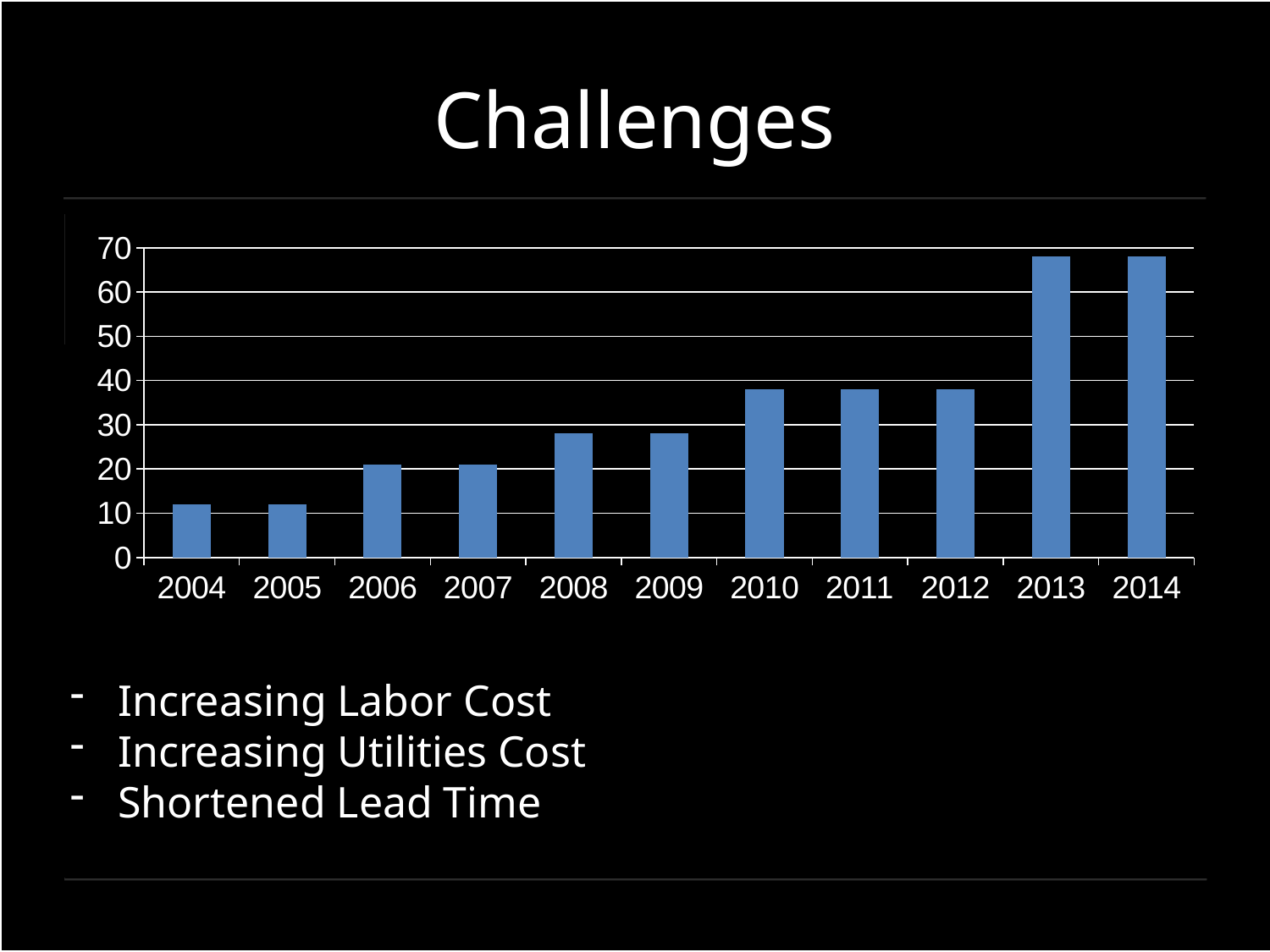
How many years are shown on the x axis of the chart? 11 Is the value for 2012 greater or less than 50? less Is the value for 2008 greater or less than 20? greater Which has the larger value, 2013 or 2004? 2013 Do the values in the chart generally rise or fall from 2004 to 2014? rise What kind of chart is shown on the slide? bar chart Which has the larger value, 2006 or 2010? 2010 Is the value for 2006 greater or less than 30? less What colour are the bars in the chart? blue